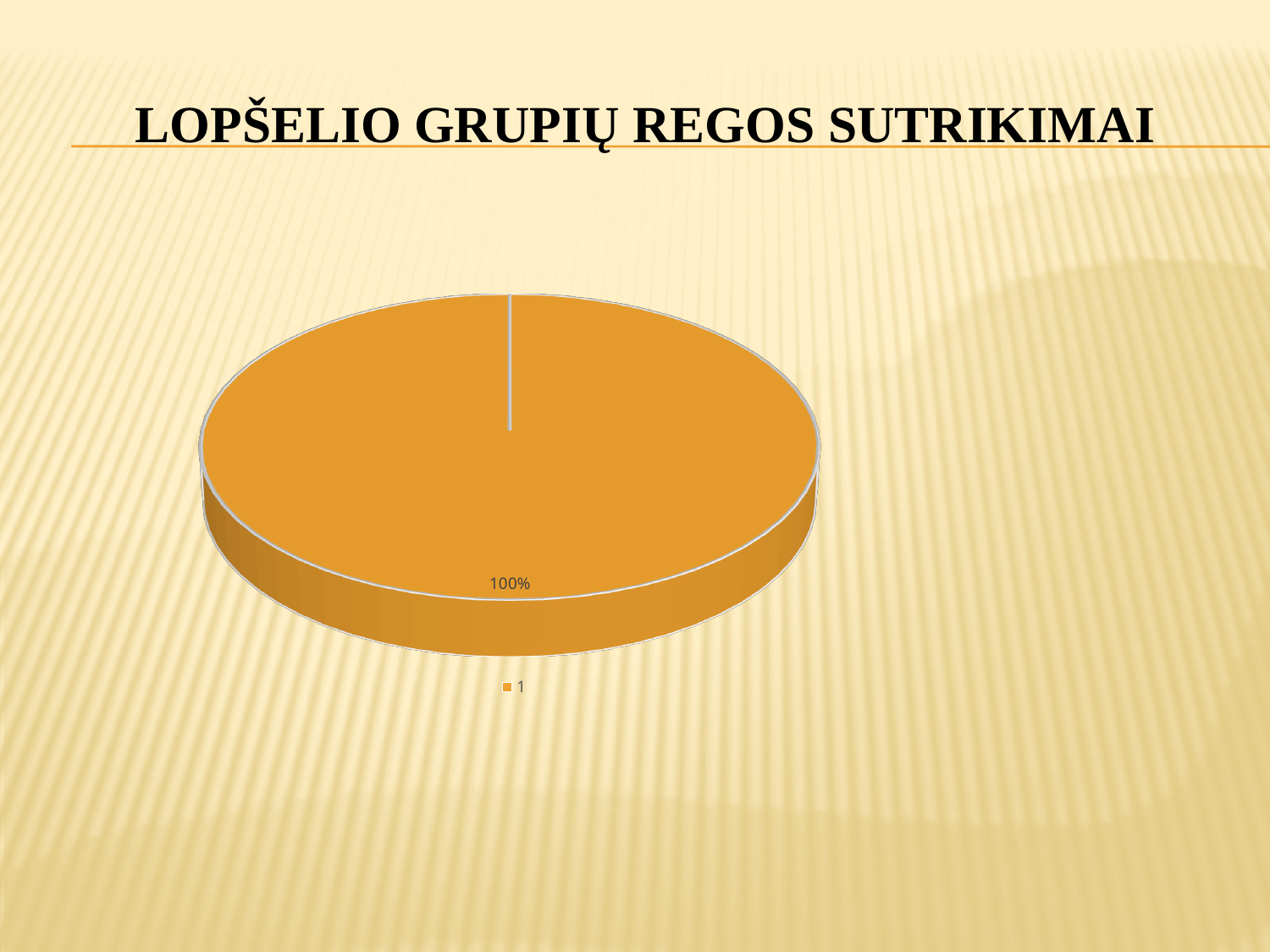
What is the data label printed on the pie slice? 100% How many slices does the pie chart have? 1 How many entries does the chart legend list? 1 What is the title of the slide containing the pie chart? LOPŠELIO GRUPIŲ REGOS SUTRIKIMAI What share of the pie does the slice labelled "1" take? 100% What is the label of the only legend entry? 1 What kind of chart is shown on the slide? pie chart